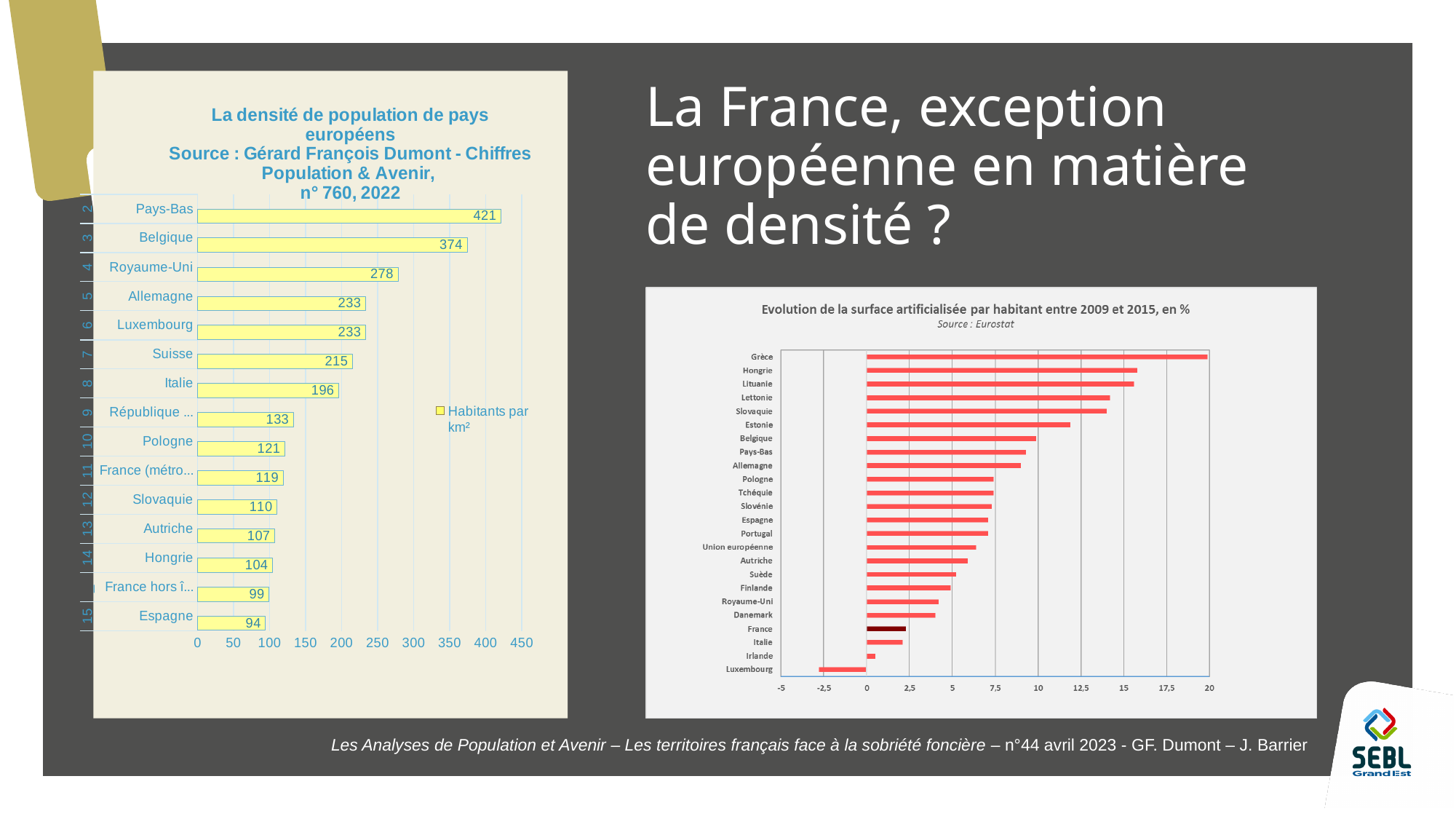
In the chart 'Evolution de la surface artificialisée par habitant entre 2009 et 2015', which country has the highest value? Grèce In the chart 'Evolution de la surface artificialisée par habitant entre 2009 et 2015', which country has the lowest value? Luxembourg In the chart 'La densité de population de pays européens', what series does the legend list? Habitants par km² In the chart 'La densité de population de pays européens', which country has the lowest value? Espagne In the chart 'La densité de population de pays européens', what is the value for Suisse? 215 In the chart 'La densité de population de pays européens', what is the value for Pays-Bas? 421 What kind of chart is 'Evolution de la surface artificialisée par habitant entre 2009 et 2015'? Bar chart In the chart 'Evolution de la surface artificialisée par habitant entre 2009 et 2015', is the value for Estonie greater or less than 10? greater In the chart 'Evolution de la surface artificialisée par habitant entre 2009 et 2015', is the value for France greater or less than 5? less In the chart 'La densité de population de pays européens', how many countries are plotted? 15 In the chart 'La densité de population de pays européens', which is larger, Pologne or Slovaquie? Pologne In the chart 'La densité de population de pays européens', what is the difference between Belgique and Royaume-Uni? 96